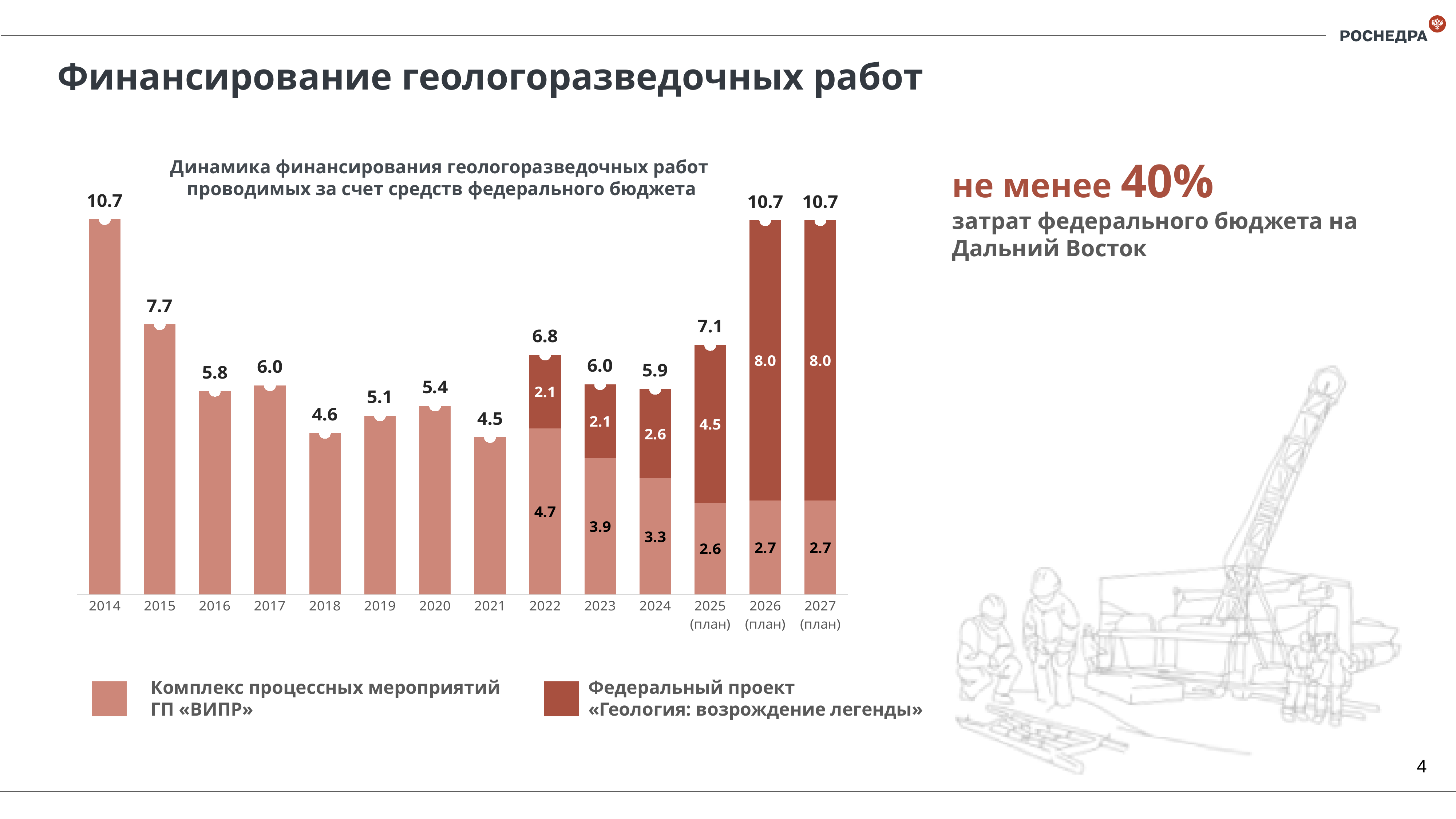
Which is larger, the total for 2019 or the total for 2020? 2020 How many series does the legend list? 2 Do the total values rise or fall from 2024 to 2026 (план)? Rise What is the value of the «Федеральный проект «Геология: возрождение легенды»» series for 2025 (план)? 4.5 How many years (categories) are shown on the x axis? 14 What is the title of the chart? Динамика финансирования геологоразведочных работ проводимых за счет средств федерального бюджета Which year has the lowest total value? 2021 What kind of chart is shown on the slide? Stacked bar chart What is the total value for 2014? 10.7 What is the value of the «Комплекс процессных мероприятий ГП «ВИПР»» series for 2023? 3.9 What is the difference between the total values for 2015 and 2016? 1.9 What is the total of the stacked bar for 2024? 5.9